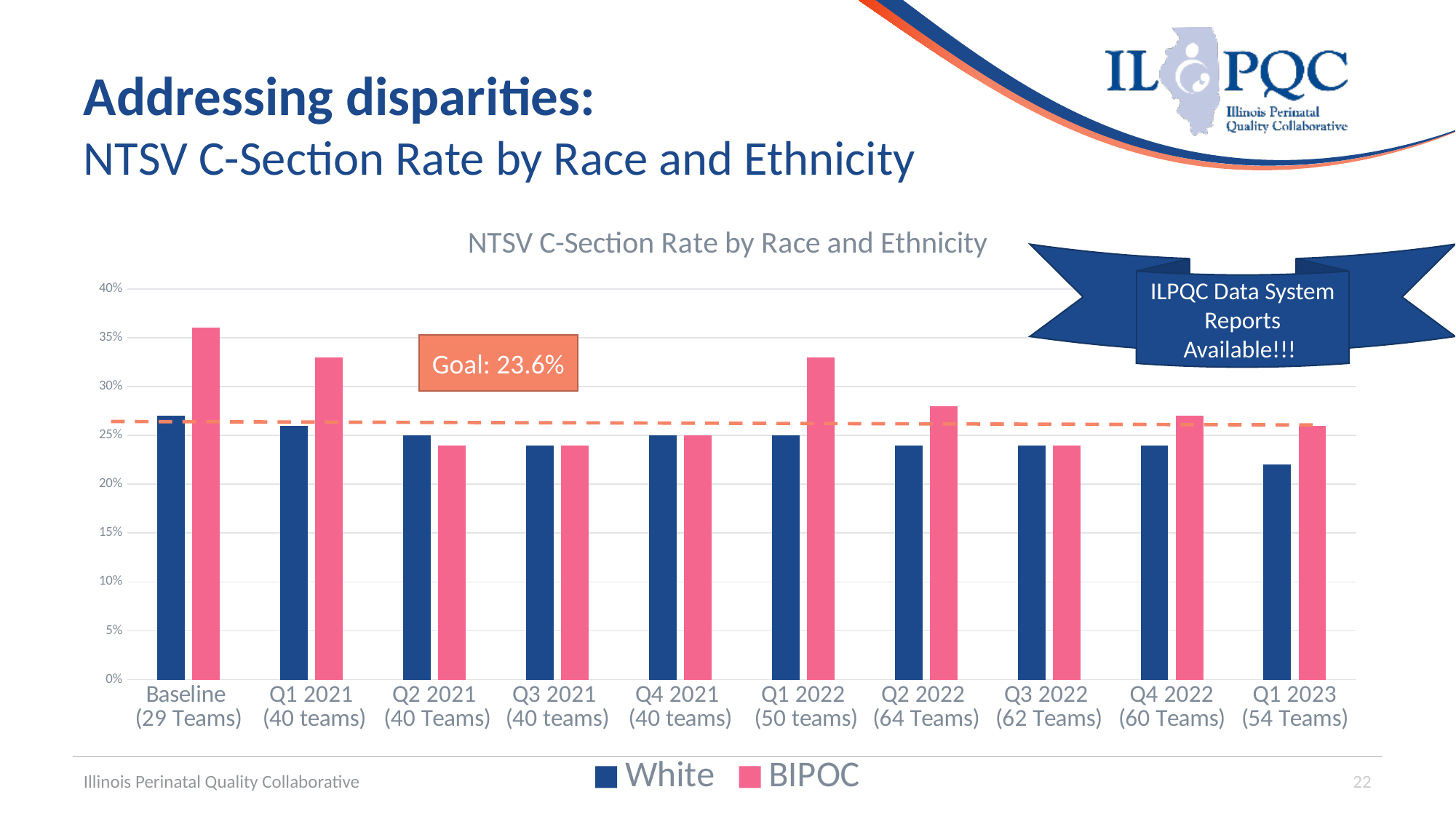
Is the White value for Q1 2023 greater or less than 25%? less At Baseline, which group has the higher NTSV C-section rate, White or BIPOC? BIPOC Which category has the highest BIPOC NTSV C-section rate? Baseline (29 Teams) What goal rate is shown in the box on the chart? 23.6% Which category has the lowest White NTSV C-section rate? Q1 2023 (54 Teams) Is the BIPOC value for Q1 2022 greater or less than 30%? greater In Q1 2022, which group has the higher NTSV C-section rate, White or BIPOC? BIPOC Is the BIPOC value at Baseline greater or less than 30%? greater How many series does the legend list? 2 How many time-period categories are shown on the x axis? 10 What kind of chart is shown on the slide? bar chart Which series is shown in pink in the legend? BIPOC